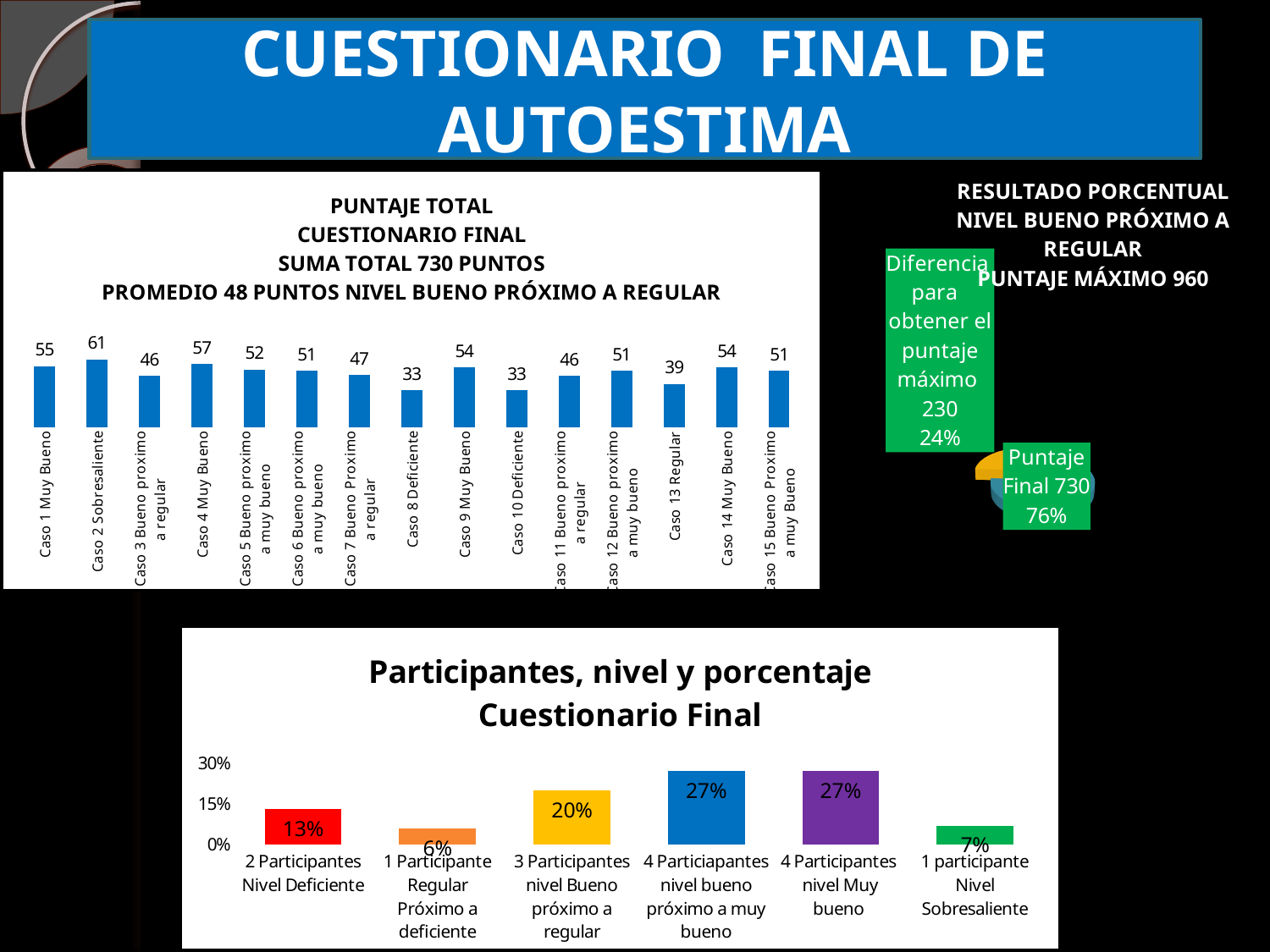
In the bottom chart (Participantes, nivel y porcentaje Cuestionario Final), which category has the lowest percentage? 1 Participante Regular Próximo a deficiente In the top-left chart (PUNTAJE TOTAL CUESTIONARIO FINAL), what is the difference between Caso 4 Muy Bueno and Caso 13 Regular? 18 In the bottom chart (Participantes, nivel y porcentaje Cuestionario Final), what is the difference between the percentage for 4 Participantes nivel Muy bueno and 2 Participantes Nivel Deficiente? 14% How many categories are shown in the bottom chart (Participantes, nivel y porcentaje Cuestionario Final)? 6 What kind of chart is the top-left chart (PUNTAJE TOTAL CUESTIONARIO FINAL)? Bar chart How many cases are plotted in the top-left chart (PUNTAJE TOTAL CUESTIONARIO FINAL)? 15 In the top-left chart (PUNTAJE TOTAL CUESTIONARIO FINAL), what is the lowest value shown? 33 In the bottom chart (Participantes, nivel y porcentaje Cuestionario Final), what percentage is shown for 3 Participantes nivel Bueno próximo a regular? 20% In the top-left chart (PUNTAJE TOTAL CUESTIONARIO FINAL), what is the value for Caso 2 Sobresaliente? 61 In the top-right chart (RESULTADO PORCENTUAL NIVEL BUENO PRÓXIMO A REGULAR), what share does Puntaje Final 730 represent? 76% In the top-left chart (PUNTAJE TOTAL CUESTIONARIO FINAL), which case has the highest score? Caso 2 Sobresaliente In the top-left chart (PUNTAJE TOTAL CUESTIONARIO FINAL), which is larger, Caso 1 Muy Bueno or Caso 7 Bueno Proximo a regular? Caso 1 Muy Bueno